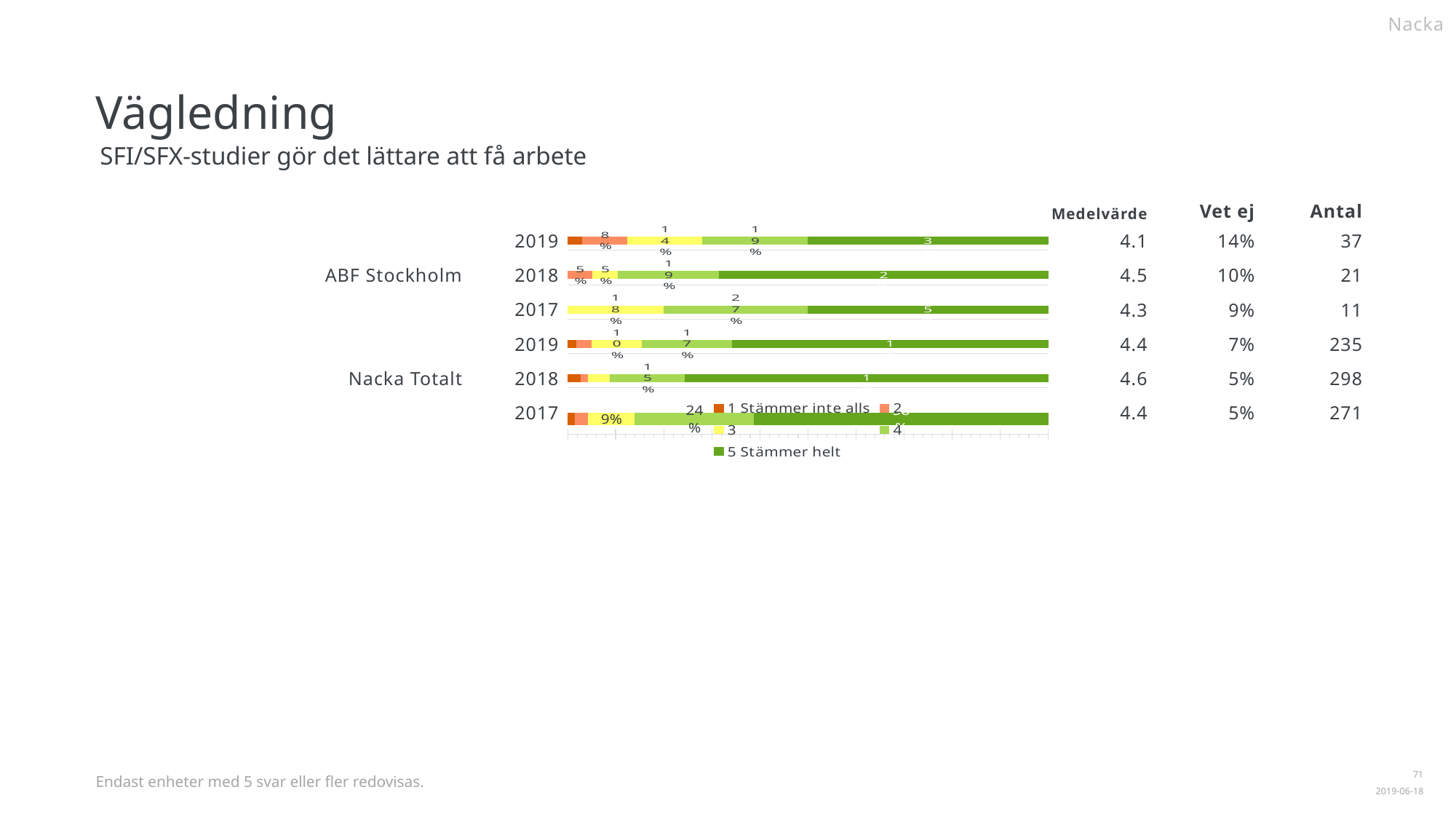
What is the value of the '4' segment for ABF Stockholm 2019? 19% Which bar has the largest '4' segment? ABF Stockholm 2017 How many bars are plotted in the chart? 6 What is the value of the '4' segment for ABF Stockholm 2017? 27% Which has the larger '4' segment: ABF Stockholm 2017 or ABF Stockholm 2019? ABF Stockholm 2017 What is the difference between the '4' segment for ABF Stockholm 2017 and the '4' segment for Nacka Totalt 2017? 3 percentage points What kind of chart is shown on the slide? Stacked bar chart What is the first entry in the chart legend? 1 Stämmer inte alls What is the value of the '4' segment for Nacka Totalt 2019? 17% How many series does the chart legend list? 5 What is the value of the '3' segment for Nacka Totalt 2017? 9%